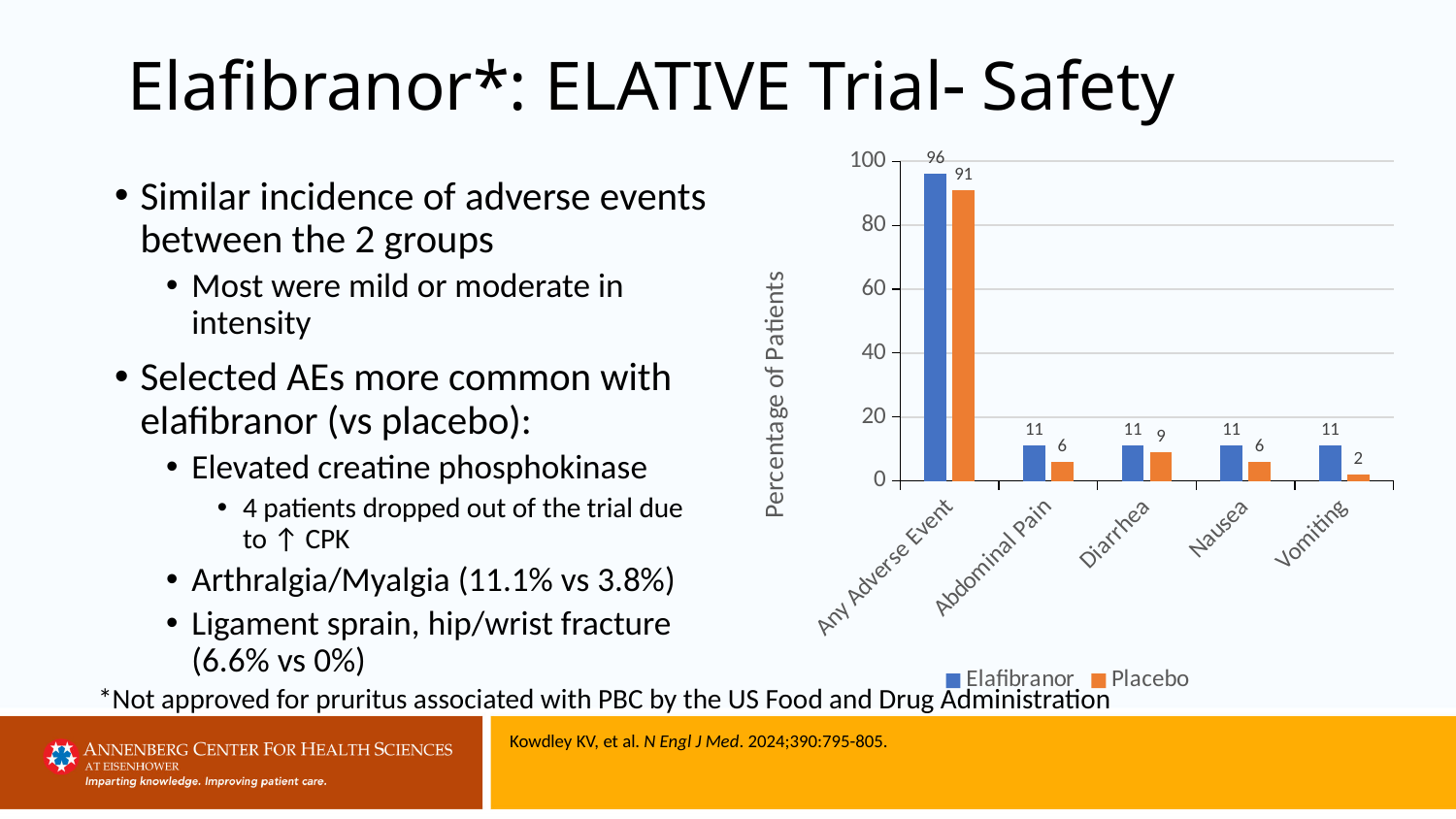
Which category has the lowest Placebo value? Vomiting What kind of chart is shown on the slide? Bar chart Which category has the highest Placebo value? Any Adverse Event What is the difference between the Elafibranor and Placebo values for Nausea? 5 What is the label of the y axis? Percentage of Patients How many categories are shown on the x axis? 5 What is the Placebo value for Diarrhea? 9 How many series does the legend list? 2 What is the Placebo value for Vomiting? 2 What is the Elafibranor value for Any Adverse Event? 96 Which is larger, the Elafibranor value for Abdominal Pain or the Placebo value for Abdominal Pain? Elafibranor What is the difference between the Elafibranor and Placebo values for Any Adverse Event? 5